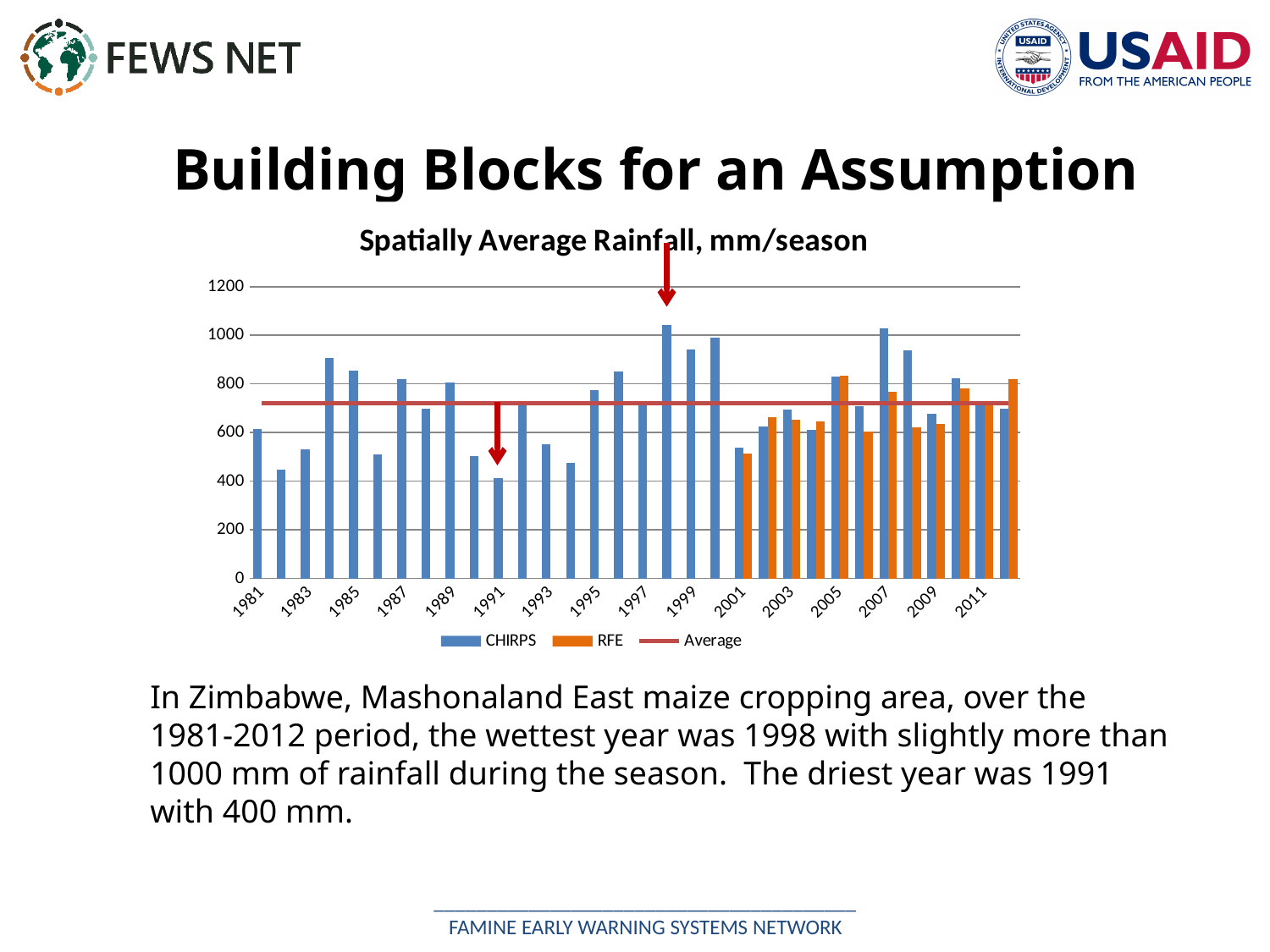
What kind of chart is shown on the slide? Bar chart How many series does the legend list? 3 For 2007, which series has the larger value, CHIRPS or RFE? CHIRPS Is the CHIRPS value for 1991 greater or less than 600? less Is the Average line greater or less than 600? greater Which series are listed in the chart legend? CHIRPS, RFE, Average Is the CHIRPS value for 1998 greater or less than 800? greater What is the title of the chart? Spatially Average Rainfall, mm/season For 2012, which series has the larger value, CHIRPS or RFE? RFE Which year has the lowest CHIRPS rainfall value? 1991 Which year has the highest CHIRPS rainfall value? 1998